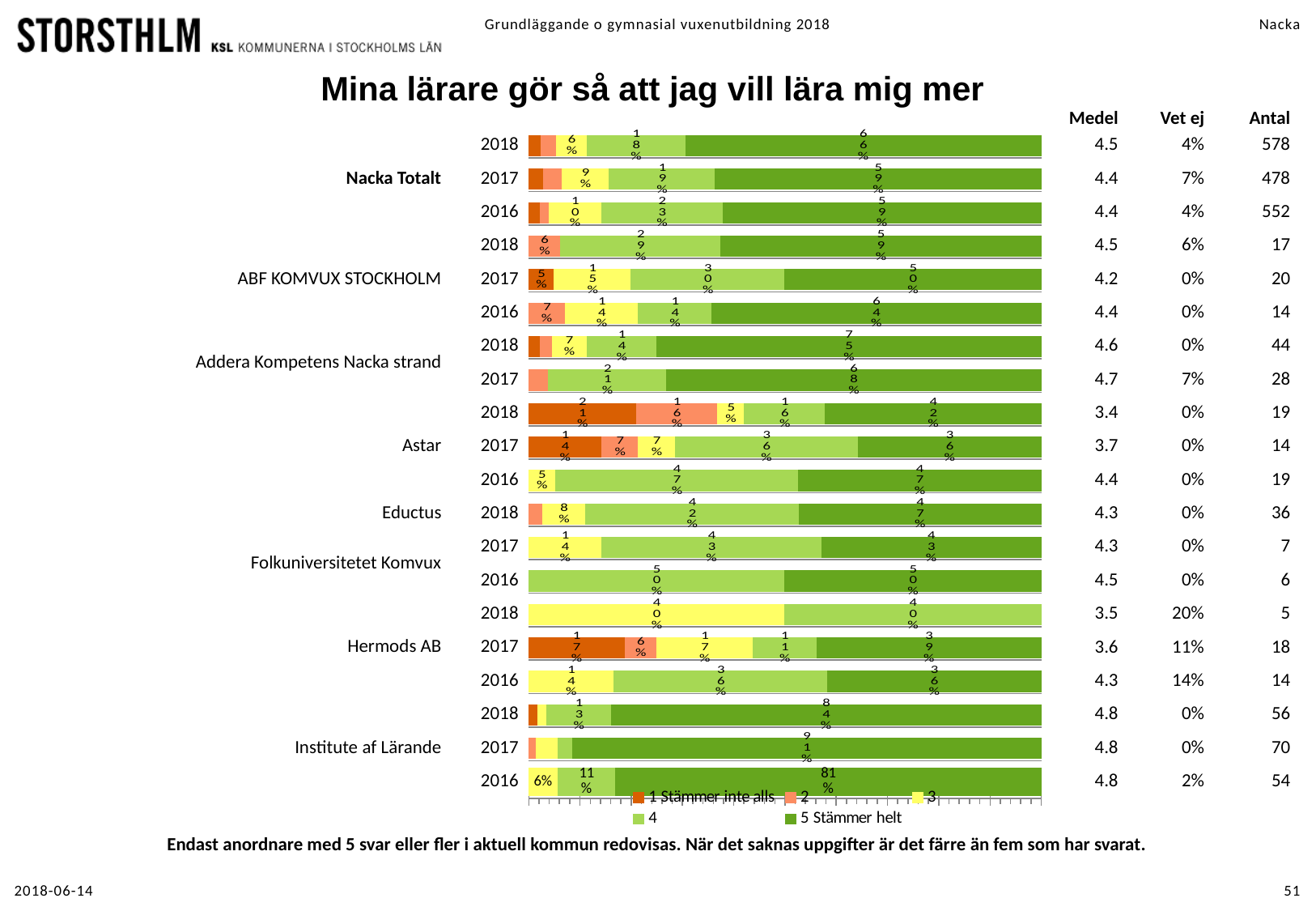
What is the value of '5 Stämmer helt' for Addera Kompetens Nacka strand in 2018? 75% What is the value of series '4' for Institute af Lärande in 2016? 11% What is the value of series '4' for Nacka Totalt in 2018? 18% What is the value of '1 Stämmer inte alls' for Astar in 2018? 21% How many bars are shown for Addera Kompetens Nacka strand? 2 What is the title of the chart? Mina lärare gör så att jag vill lära mig mer What is the value of '5 Stämmer helt' for Nacka Totalt in 2018? 66% For Nacka Totalt 2018, what is the difference between the '5 Stämmer helt' value and the series '4' value? 48% What is the value of '5 Stämmer helt' for Institute af Lärande in 2016? 81% Which has the larger '5 Stämmer helt' share: Institute af Lärande 2016 or Astar 2018? Institute af Lärande 2016 How many series does the chart legend list? 5 What kind of chart is shown on the slide? Stacked bar chart